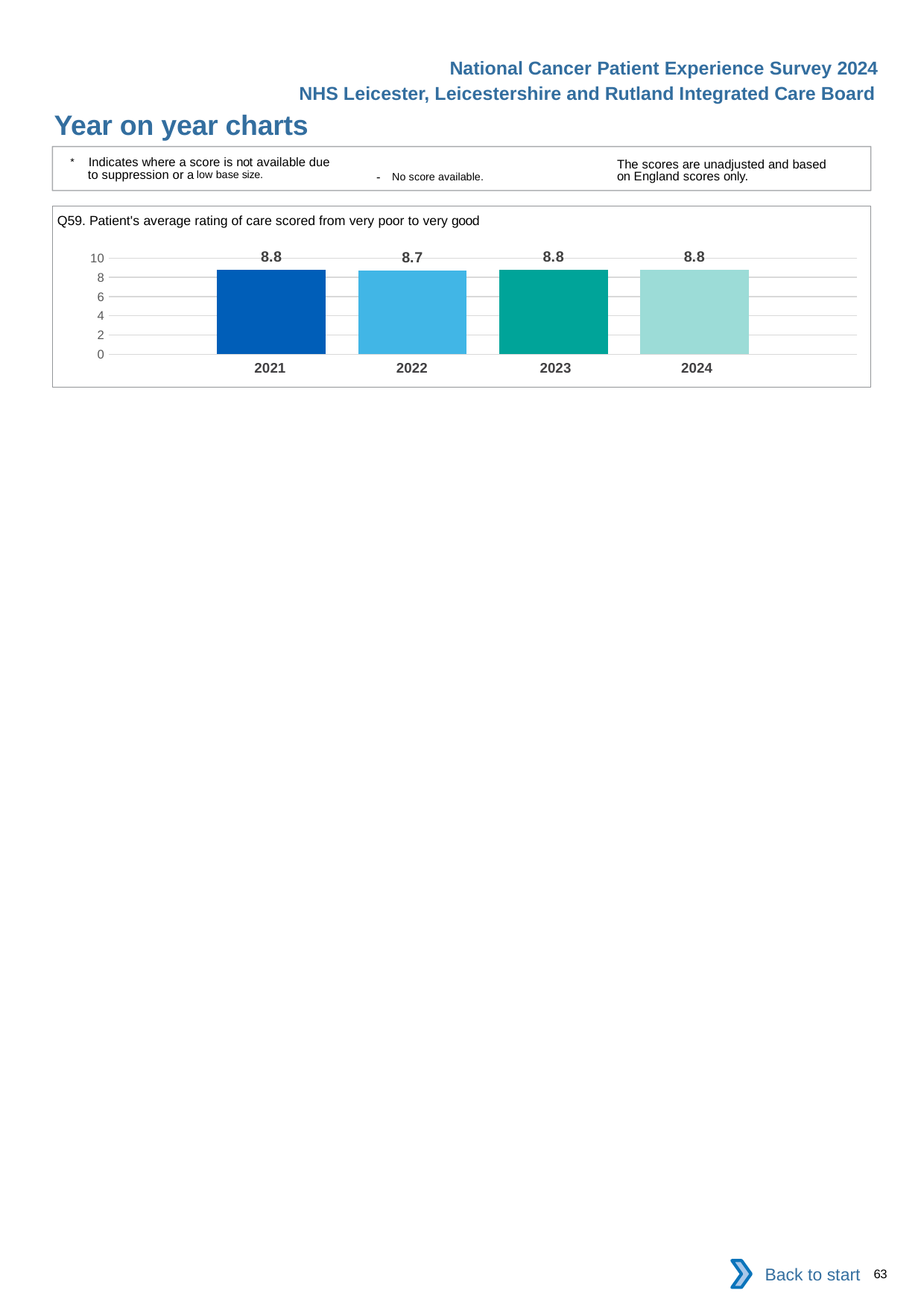
What is the value for 2024? 8.8 How many years are shown on the x axis? 4 What is the highest value shown on the y axis? 10 What is the value for 2022? 8.7 What is the value for 2021? 8.8 Is the value for 2024 greater or less than 8? greater What is the title of the chart? Q59. Patient's average rating of care scored from very poor to very good Which is larger, the value for 2022 or the value for 2023? 2023 What is the difference between the values for 2021 and 2022? 0.1 Which year has the lowest value? 2022 What is the value for 2023? 8.8 What kind of chart is this? bar chart